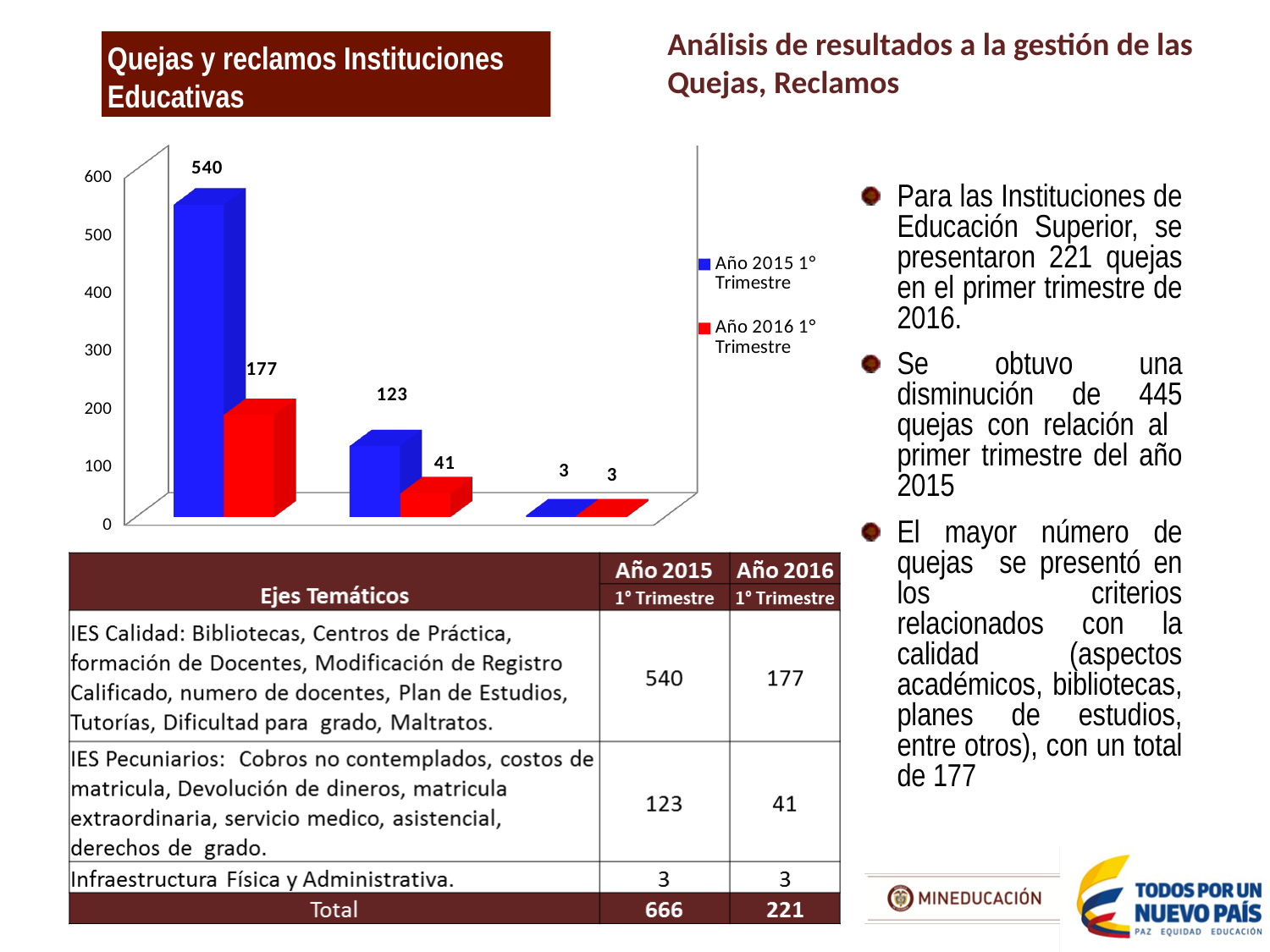
What is the value of the Año 2015 1° Trimestre bar in the first (leftmost) group? 540 Which bar in the chart has the highest value? Año 2015 1° Trimestre in the first group (540) What kind of chart is shown on the slide? Bar chart What colour represents the Año 2016 1° Trimestre series in the chart? Red What is the value of the Año 2016 1° Trimestre bar in the second (middle) group? 41 What is the difference between the Año 2015 1° Trimestre and Año 2016 1° Trimestre bars in the first group? 363 How many groups of bars are plotted in the chart? 3 How many series does the chart legend list? 2 What is the value of the Año 2015 1° Trimestre bar in the second (middle) group? 123 What is the value of the Año 2016 1° Trimestre bar in the first (leftmost) group? 177 Which is larger: the Año 2016 1° Trimestre bar in the first group or the Año 2015 1° Trimestre bar in the second group? Año 2016 1° Trimestre bar in the first group (177) What is the difference between the Año 2015 1° Trimestre and Año 2016 1° Trimestre bars in the second group? 82